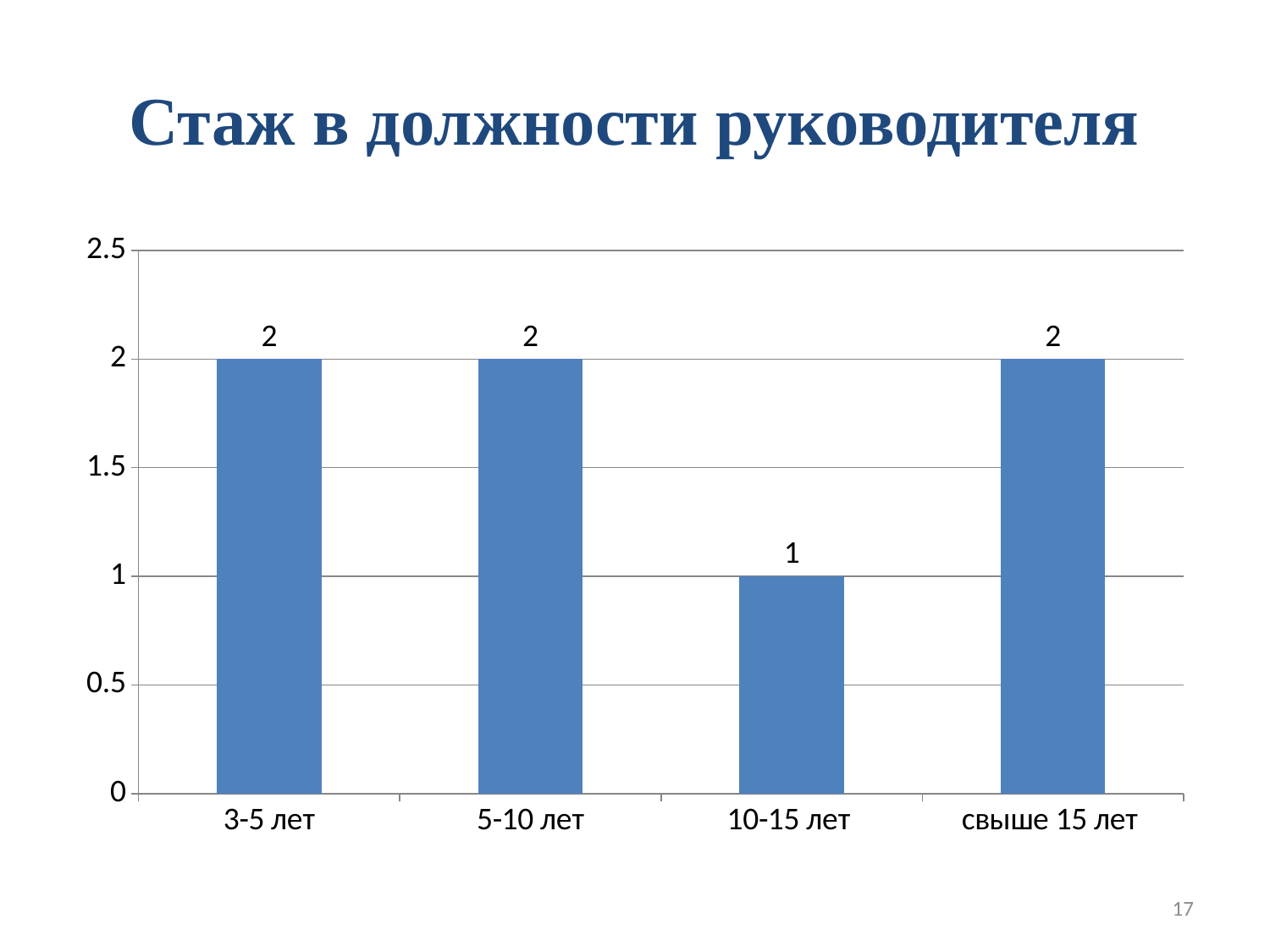
Which category has the lowest value? 10-15 лет What is the value for 5-10 лет? 2 What kind of chart is shown on the slide? bar chart Which is larger, the value for 3-5 лет or the value for 10-15 лет? 3-5 лет What is the title of the slide? Стаж в должности руководителя What is the difference between the values for 5-10 лет and 10-15 лет? 1 How many categories are shown on the x axis? 4 Is the value for 10-15 лет greater or less than 1.5? less What is the value for 10-15 лет? 1 What is the value for 3-5 лет? 2 What is the highest value shown on the vertical axis? 2.5 What is the value for свыше 15 лет? 2